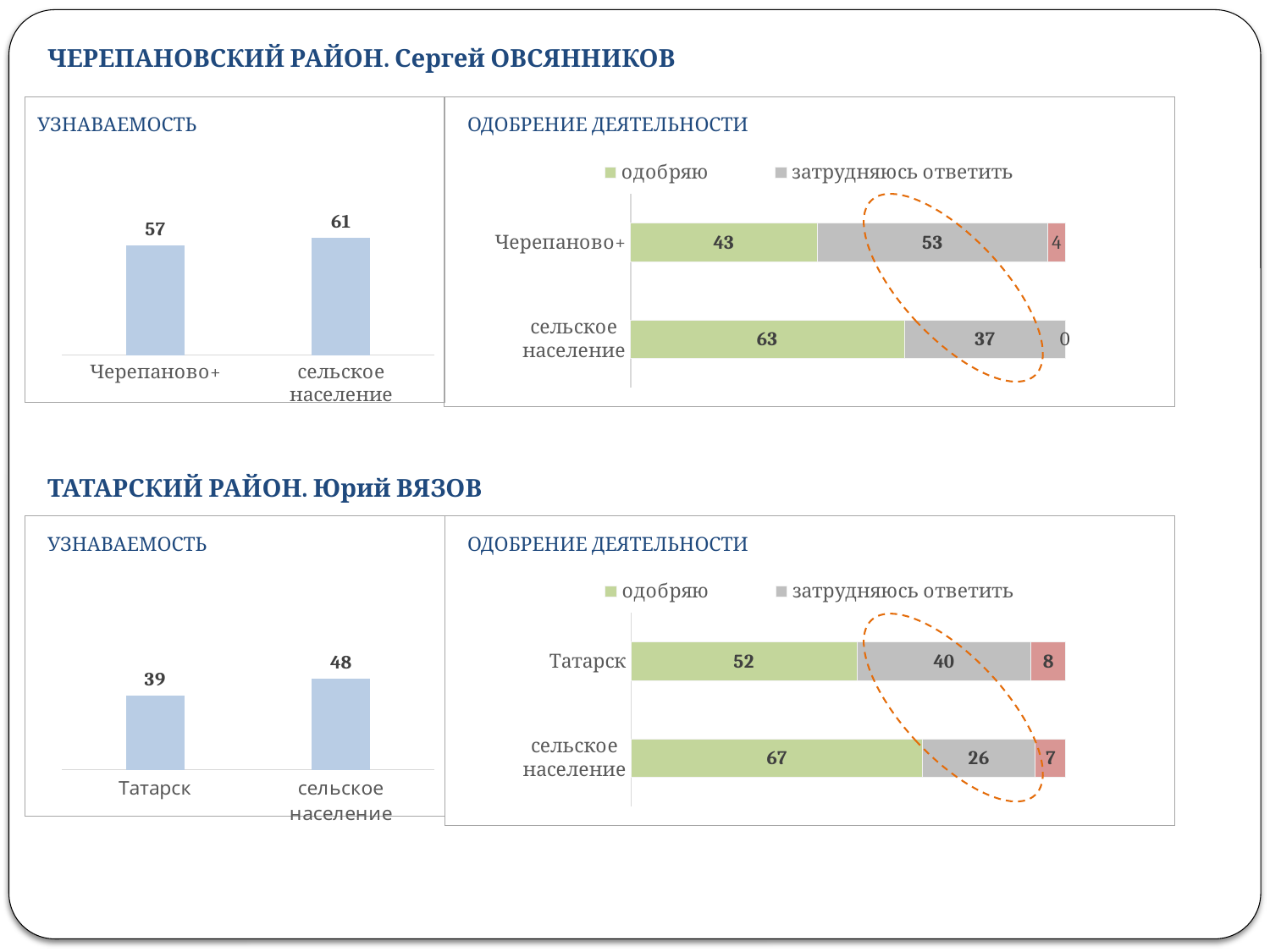
In the УЗНАВАЕМОСТЬ chart for Черепановский район (top left), what is the value for Черепаново+? 57 In the ОДОБРЕНИЕ ДЕЯТЕЛЬНОСТИ chart for Черепановский район (top right), what is the одобряю value for сельское население? 63 In the УЗНАВАЕМОСТЬ chart for Черепановский район (top left), what is the difference between сельское население and Черепаново+? 4 In the ОДОБРЕНИЕ ДЕЯТЕЛЬНОСТИ chart for Черепановский район (top right), what is the total of the Черепаново+ bar? 100 In the УЗНАВАЕМОСТЬ chart for Татарский район (bottom left), what is the value for Татарск? 39 In the ОДОБРЕНИЕ ДЕЯТЕЛЬНОСТИ chart for Татарский район (bottom right), which is larger: the одобряю value for Татарск or for сельское население? сельское население What kind of chart is the УЗНАВАЕМОСТЬ chart for Татарский район (bottom left)? bar chart In the УЗНАВАЕМОСТЬ chart for Черепановский район (top left), which category has the higher value? сельское население In the ОДОБРЕНИЕ ДЕЯТЕЛЬНОСТИ chart for Татарский район (bottom right), what is the одобряю value for Татарск? 52 In the ОДОБРЕНИЕ ДЕЯТЕЛЬНОСТИ chart for Черепановский район (top right), what is the затрудняюсь ответить value for Черепаново+? 53 In the ОДОБРЕНИЕ ДЕЯТЕЛЬНОСТИ chart for Татарский район (bottom right), what is the difference between the затрудняюсь ответить values for Татарск and сельское население? 14 In the УЗНАВАЕМОСТЬ chart for Татарский район (bottom left), which category has the lower value? Татарск